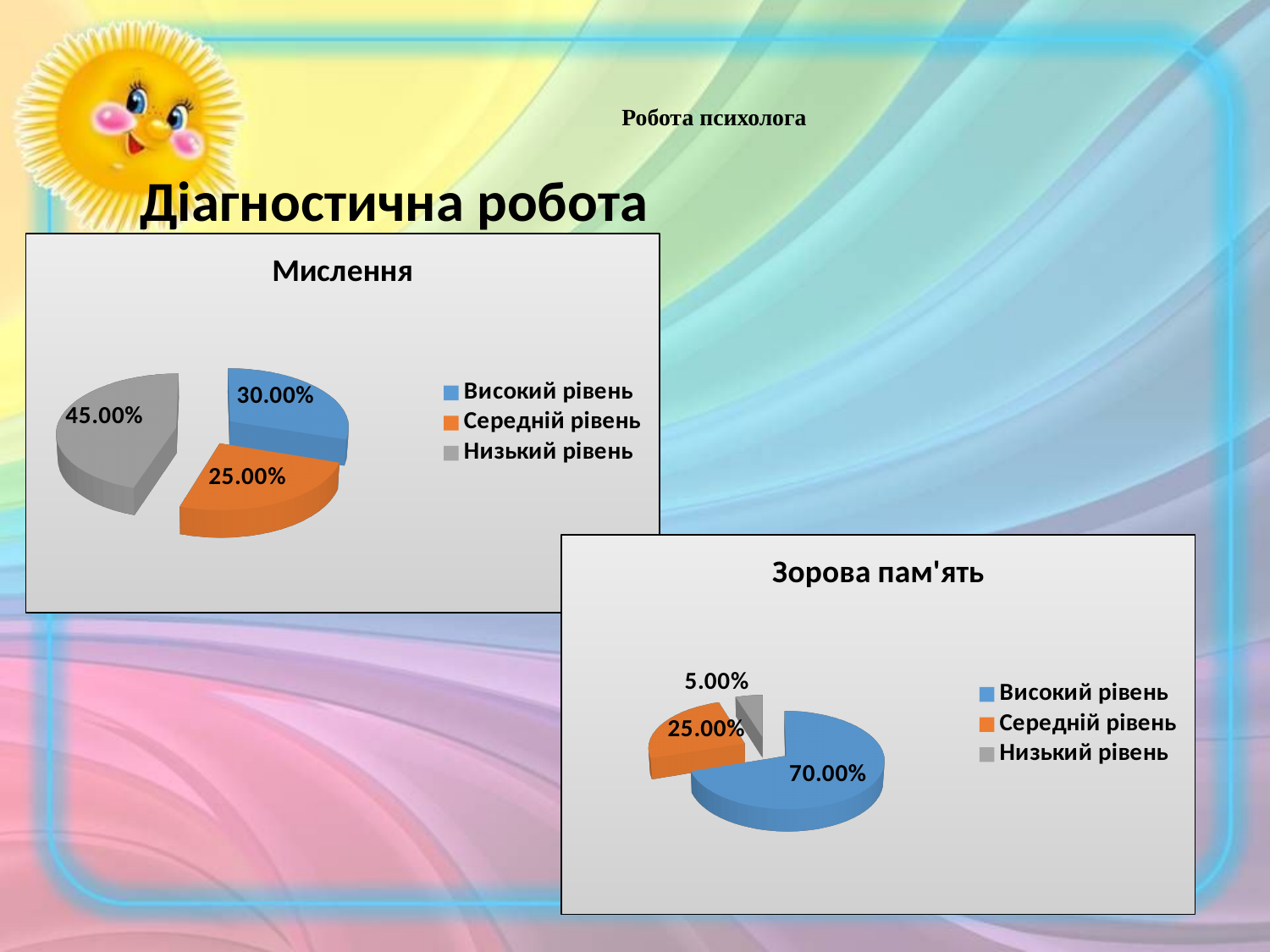
How many categories does the legend of the "Мислення" chart list? 3 In the "Мислення" chart, which category has the largest share? Низький рівень In the "Мислення" chart, what is the value for Високий рівень? 30.00% What kind of chart is the "Зорова пам'ять" chart? Pie chart In the "Зорова пам'ять" chart, what is the value for Високий рівень? 70.00% In the "Мислення" chart, which category has the smallest share? Середній рівень In the "Зорова пам'ять" chart, which category has the smallest share? Низький рівень In the "Мислення" chart, what is the value for Низький рівень? 45.00% In the "Мислення" chart, what is the difference between Низький рівень and Середній рівень? 20.00% In the "Зорова пам'ять" chart, what is the value for Низький рівень? 5.00% Which is larger: Високий рівень in the "Мислення" chart or Високий рівень in the "Зорова пам'ять" chart? Зорова пам'ять In the "Зорова пам'ять" chart, what is the difference between Високий рівень and Середній рівень? 45.00%